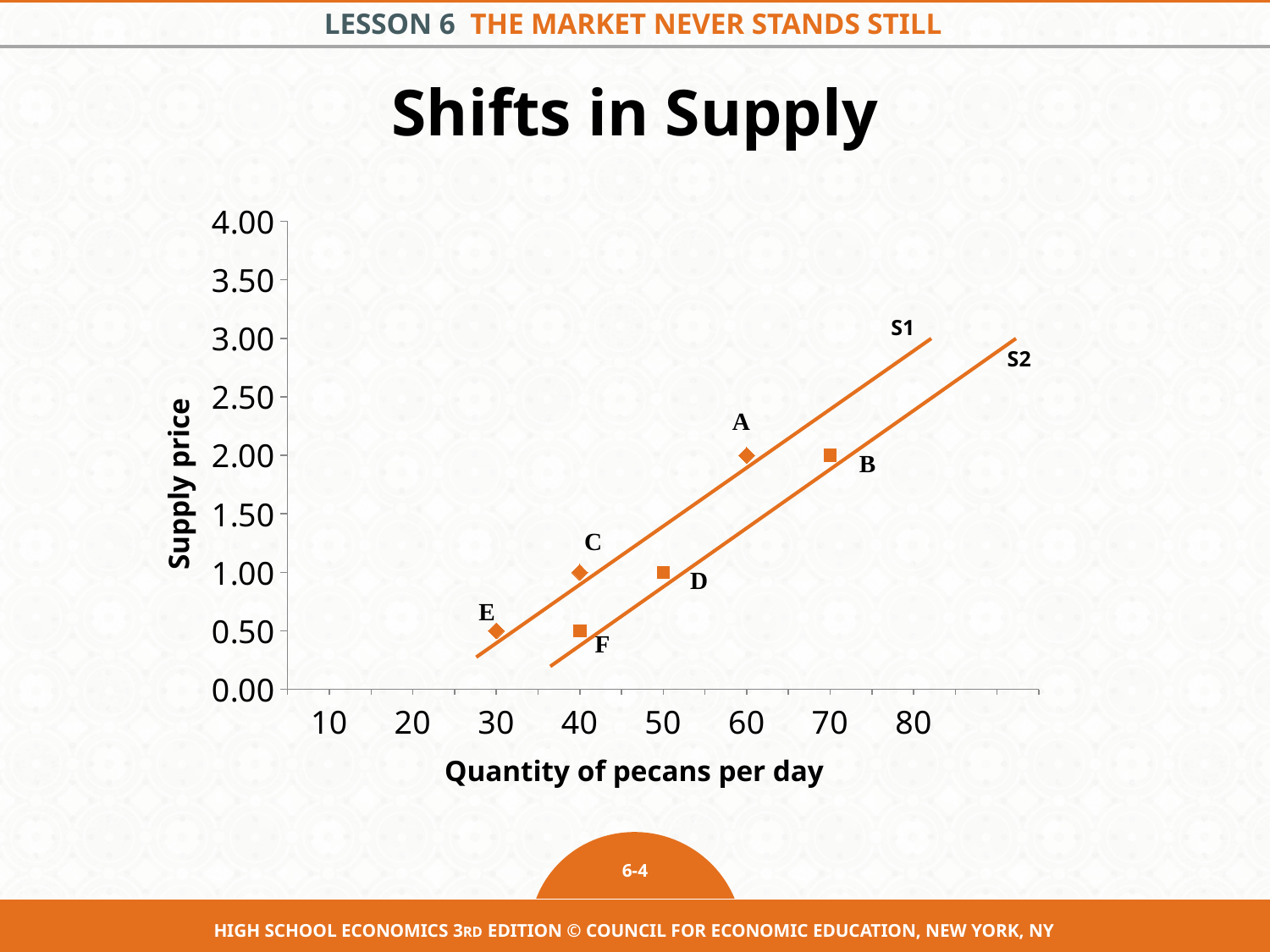
What quantity of pecans per day corresponds to point B? 70 How many labeled data points are plotted on the chart? 6 What quantity of pecans per day corresponds to point D? 50 What kind of chart is shown on the slide? scatter chart What is the supply price at point E? 0.50 What is the title of the chart? Shifts in Supply What is the supply price at point A? 2.00 What is the label of the vertical axis? Supply price Which labeled point has the lowest quantity of pecans per day? E What is the difference in quantity between point B and point A? 10 Which point has a higher supply price, C or F? C Do supply prices rise or fall as the quantity of pecans per day increases along the x axis? rise